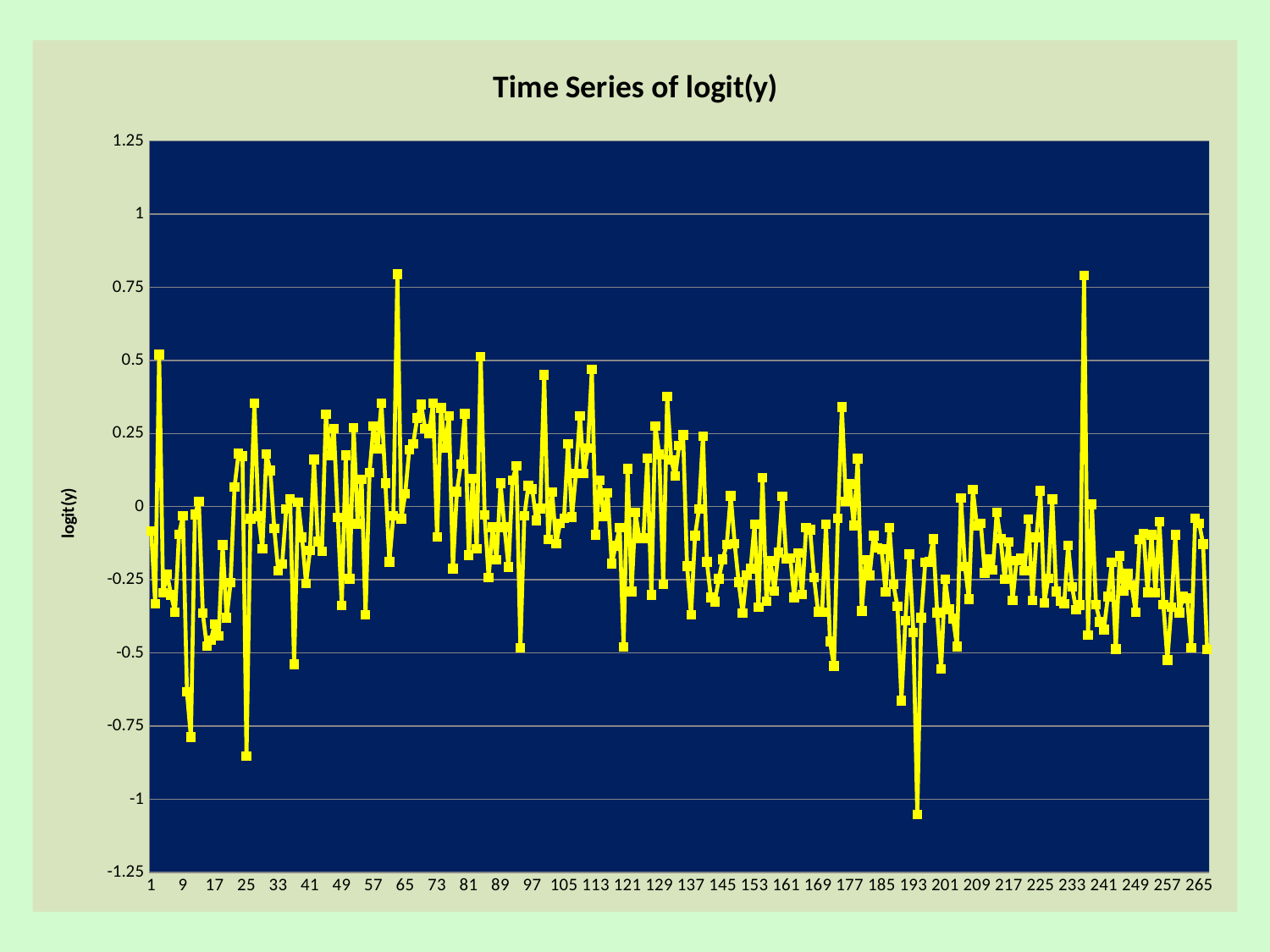
What kind of chart is shown on the slide? line chart What is the last tick label on the horizontal axis? 265 Is the highest value in the series greater or less than 0.75? greater Is the lowest value in the series greater or less than -1? less What is the label on the vertical axis of the chart? logit(y) What is the lowest value shown on the vertical axis? -1.25 Is the value at the deep dip near x = 25 greater or less than -0.5? less